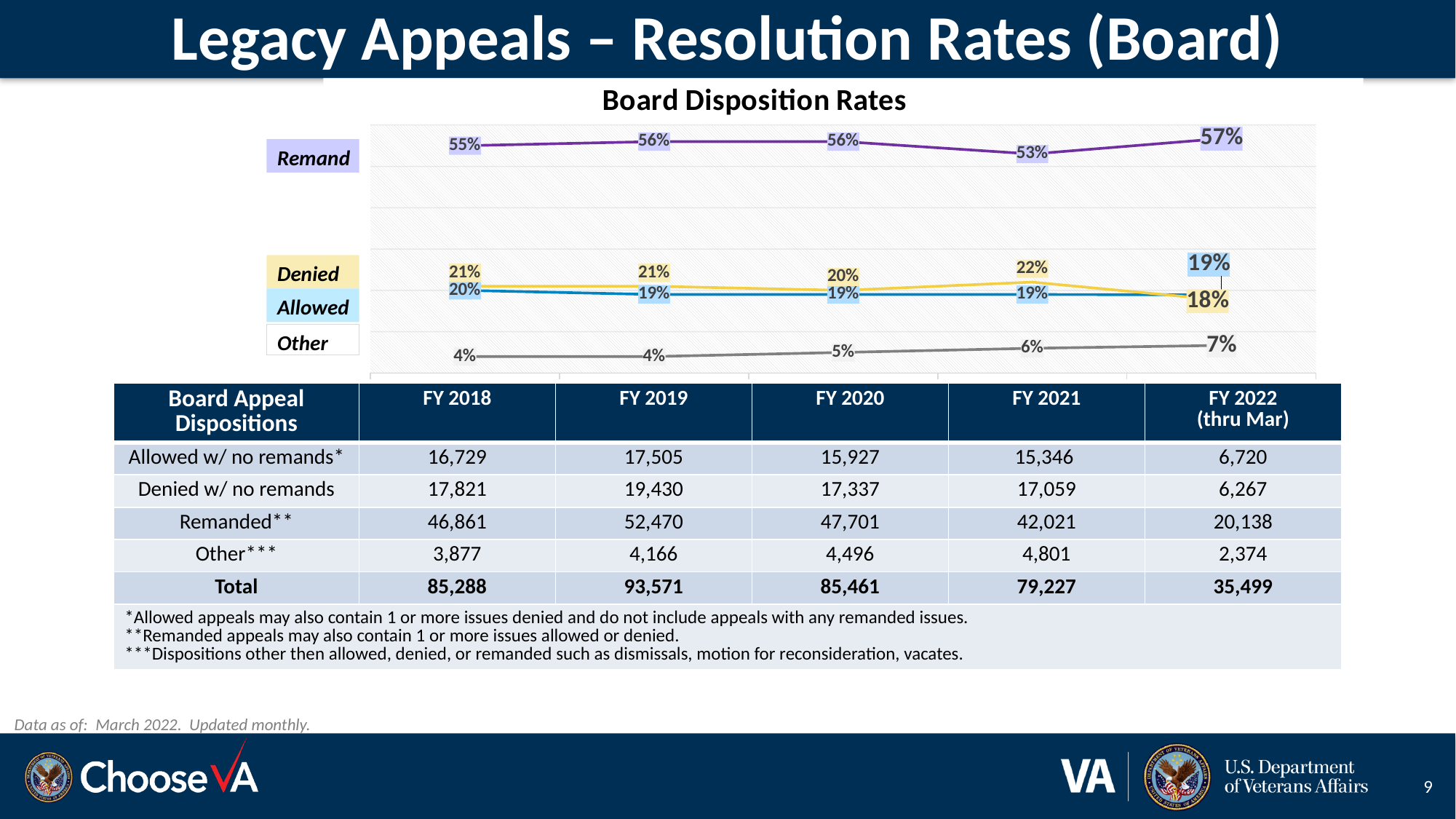
In the Board Disposition Rates chart, what is the Other rate for FY 2022? 7% How many fiscal years are plotted in the Board Disposition Rates chart? 5 In the Board Disposition Rates chart, what is the Remand rate for FY 2021? 53% In the Board Disposition Rates chart, does the Other rate rise or fall from FY 2018 to FY 2022? rise What type of chart is the Board Disposition Rates chart? line chart In the Board Disposition Rates chart, in which fiscal year is the Remand rate lowest? FY 2021 In the Board Disposition Rates chart, which is larger in FY 2022, the Allowed rate or the Denied rate? Allowed In the Board Disposition Rates chart, what is the Allowed rate for FY 2018? 20% In the Board Disposition Rates chart, what is the difference between the Remand rate and the Other rate in FY 2022? 50% In the Board Disposition Rates chart, in which fiscal year is the Remand rate highest? FY 2022 In the Board Disposition Rates chart, what is the Denied rate for FY 2021? 22% How many series are shown in the Board Disposition Rates chart? 4